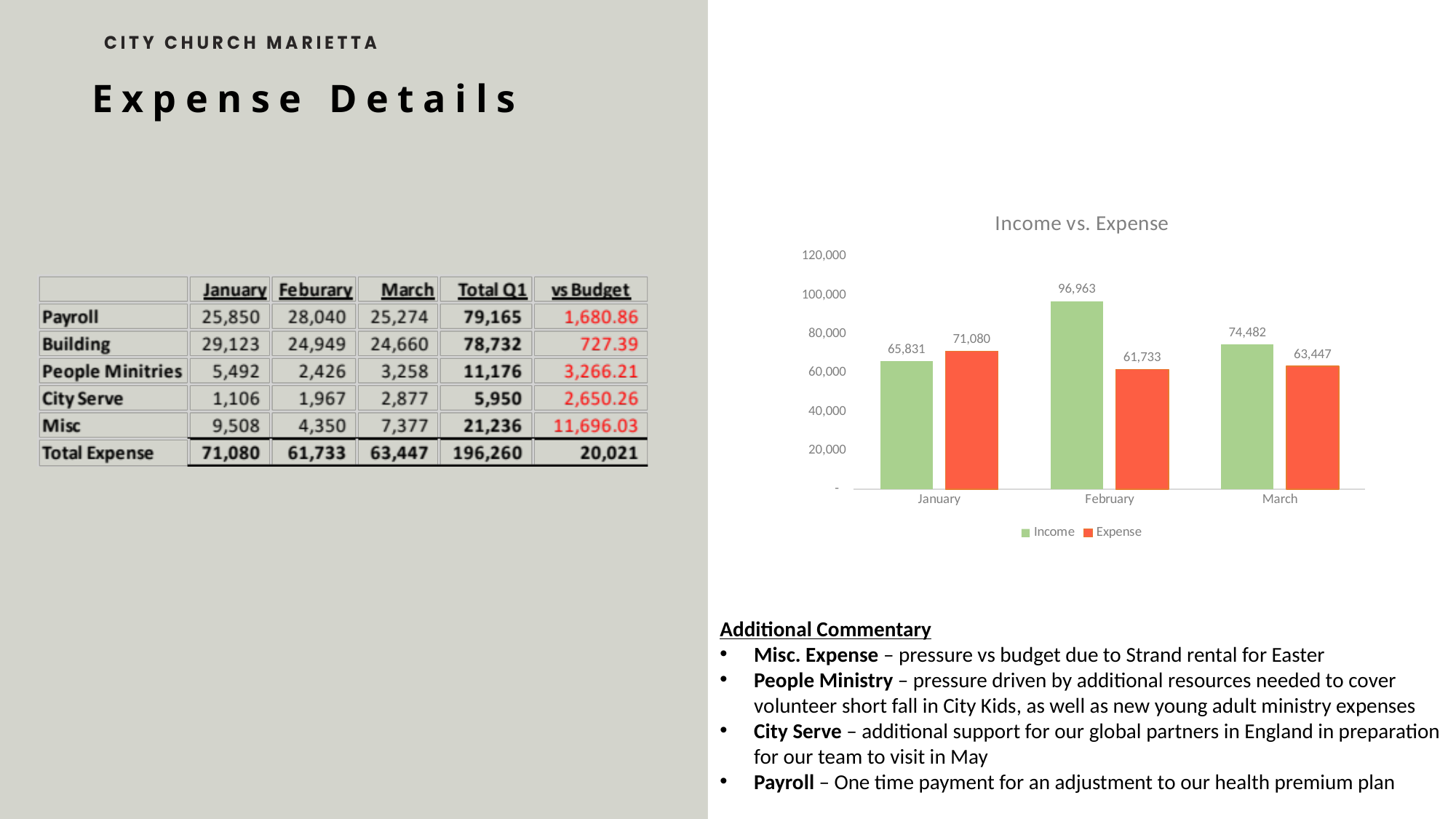
Which month has the highest Income in the Income vs. Expense chart? February What kind of chart is the Income vs. Expense chart? bar chart How many months are shown on the x axis of the Income vs. Expense chart? 3 What is the Income value for February in the Income vs. Expense chart? 96,963 Which month has the lowest Expense in the Income vs. Expense chart? February What is the Expense value for January in the Income vs. Expense chart? 71,080 How many series does the legend of the Income vs. Expense chart list? 2 What is the difference between Income and Expense in February in the Income vs. Expense chart? 35,230 What is the Income value for March in the Income vs. Expense chart? 74,482 Is the Income value for February greater or less than 80,000 in the Income vs. Expense chart? greater What colour are the Expense bars in the Income vs. Expense chart? red In January, which is larger in the Income vs. Expense chart, Income or Expense? Expense